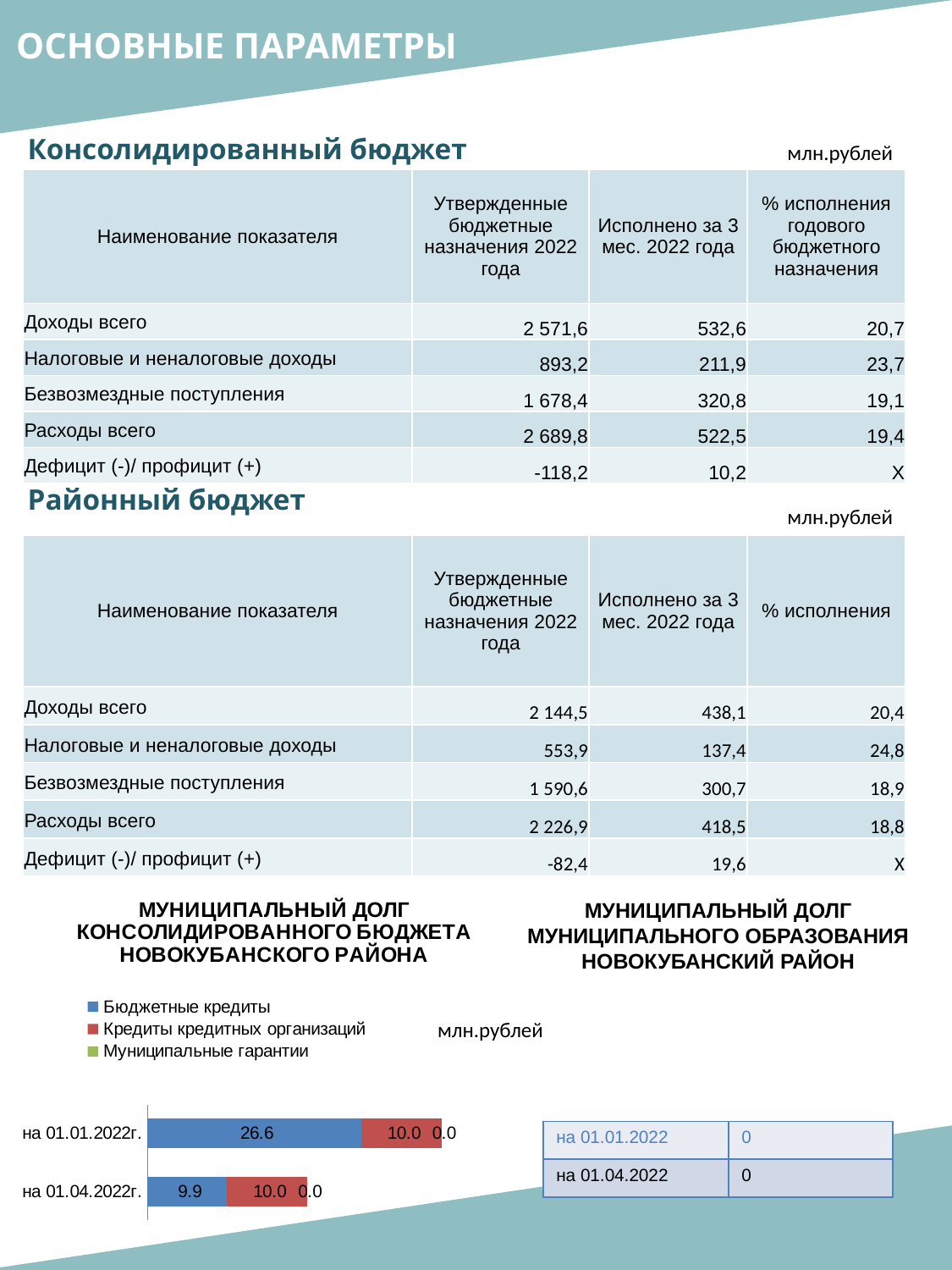
In the municipal debt chart, which date has the larger value for 'Бюджетные кредиты': 'на 01.01.2022г.' or 'на 01.04.2022г.'? на 01.01.2022г. In the municipal debt chart, by how much did 'Бюджетные кредиты' decrease from 'на 01.01.2022г.' to 'на 01.04.2022г.'? 16.7 In the municipal debt chart, what is the value of 'Бюджетные кредиты' for 'на 01.01.2022г.'? 26.6 What kind of chart is shown under the title 'МУНИЦИПАЛЬНЫЙ ДОЛГ КОНСОЛИДИРОВАННОГО БЮДЖЕТА НОВОКУБАНСКОГО РАЙОНА'? bar chart In the municipal debt chart, which colour represents 'Кредиты кредитных организаций'? red In the municipal debt chart, what is the value of 'Муниципальные гарантии' for 'на 01.01.2022г.'? 0.0 In the municipal debt chart, what is the total of the stacked bar for 'на 01.04.2022г.'? 19.9 In the municipal debt chart, what is the value of 'Кредиты кредитных организаций' for 'на 01.04.2022г.'? 10.0 How many series does the legend of the municipal debt chart list? 3 How many categories (dates) are plotted in the municipal debt chart? 2 In the municipal debt chart, what is the total of the stacked bar for 'на 01.01.2022г.'? 36.6 In the municipal debt chart, what is the value of 'Бюджетные кредиты' for 'на 01.04.2022г.'? 9.9